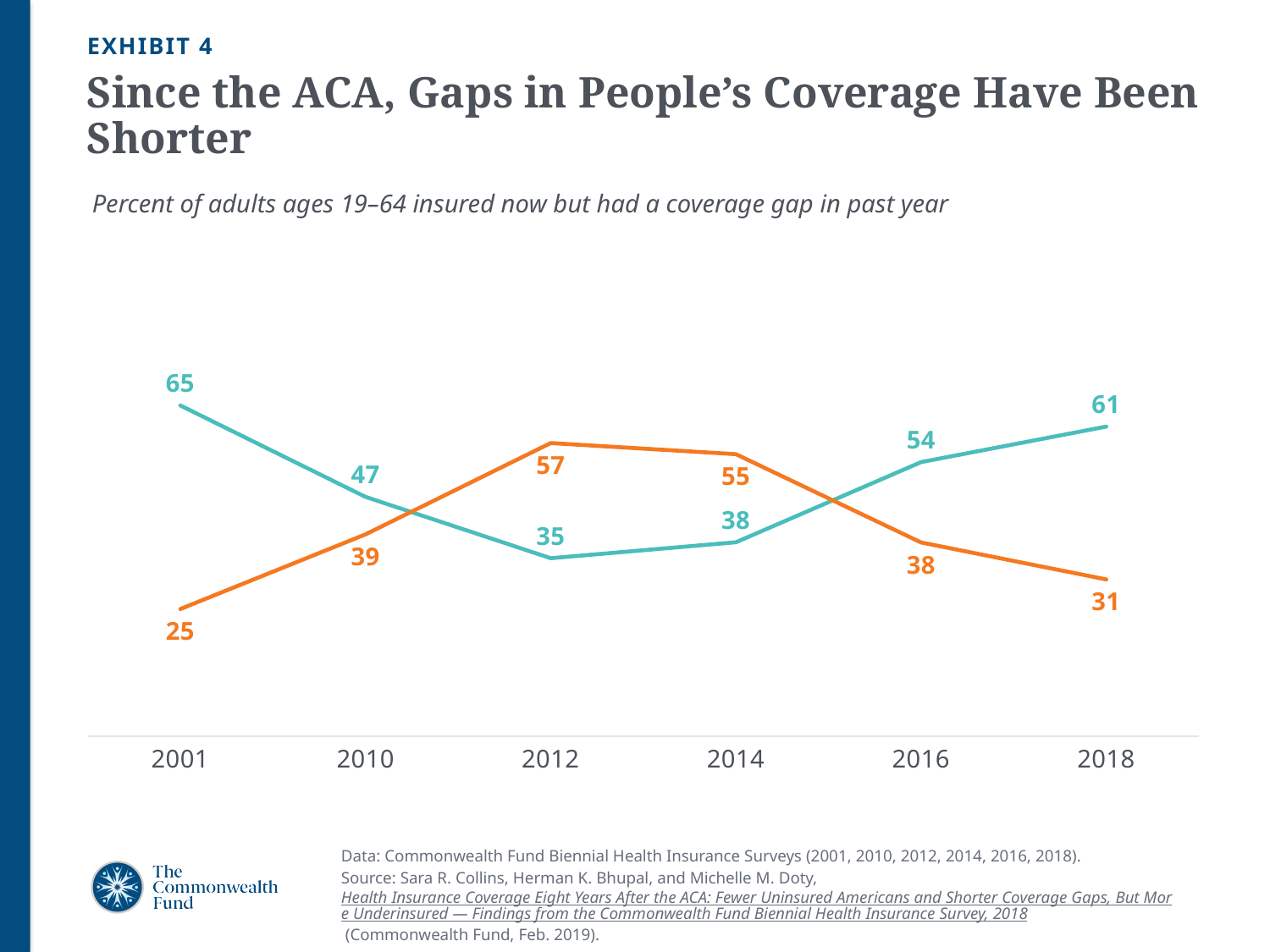
What is the difference between the teal and orange values in 2018? 30 What is the value of the teal line in 2001? 65 What is the value of the orange line in 2012? 57 How many years are shown on the x axis? 6 In which year does the teal line reach its lowest value? 2012 In which year does the orange line reach its highest value? 2012 Does the orange line rise or fall from 2014 to 2018? fall What is the value of the orange line in 2001? 25 What is the value of the teal line in 2018? 61 In 2014, which line has the larger value, teal or orange? orange How many lines are plotted on the chart? 2 What kind of chart is shown on the slide? line chart